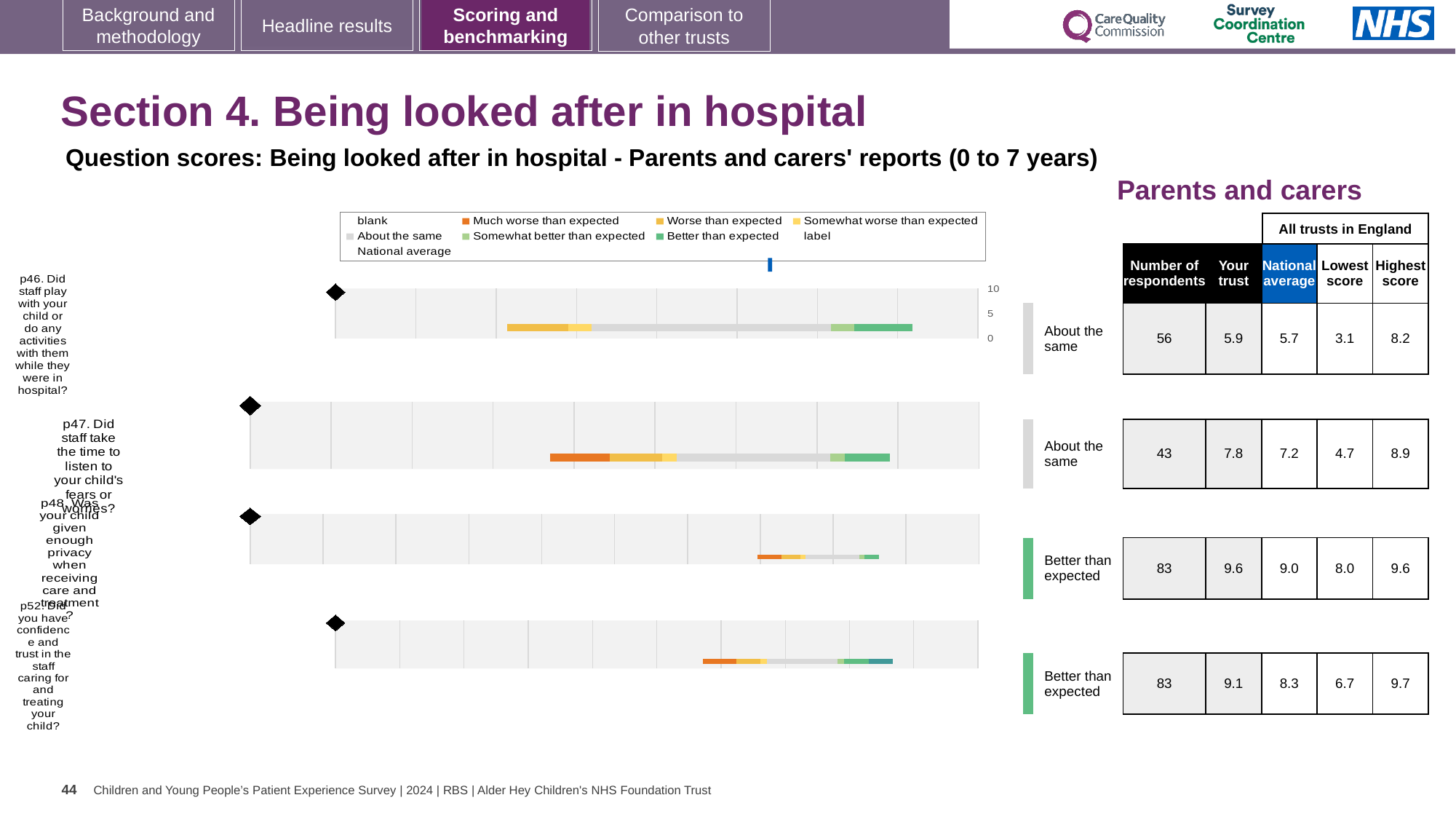
What is the highest score among all trusts in England for p52 (Did you have confidence and trust in the staff caring for and treating your child?)? 9.7 Which question has the highest 'Your trust' score? p48 For p46, what is the difference between the 'Your trust' score (5.9) and the national average (5.7)? 0.2 How many respondents answered p48 (Was your child given enough privacy when receiving care and treatment?)? 83 Is the 'Your trust' score for p48 greater or less than 5? greater For p52, which is larger: the 'Your trust' score or the national average? Your trust What benchmark category is shown for p47? About the same How many questions (p46, p47, p48, p52) are plotted on the slide? 4 What is the national average score for p47 (Did staff take the time to listen to your child's fears or worries?)? 7.2 What kind of chart is used to show the question scores on this slide? bar chart Which question has the lowest 'Your trust' score? p46 What is the 'Your trust' score for p46 (Did staff play with your child or do any activities with them while they were in hospital?)? 5.9